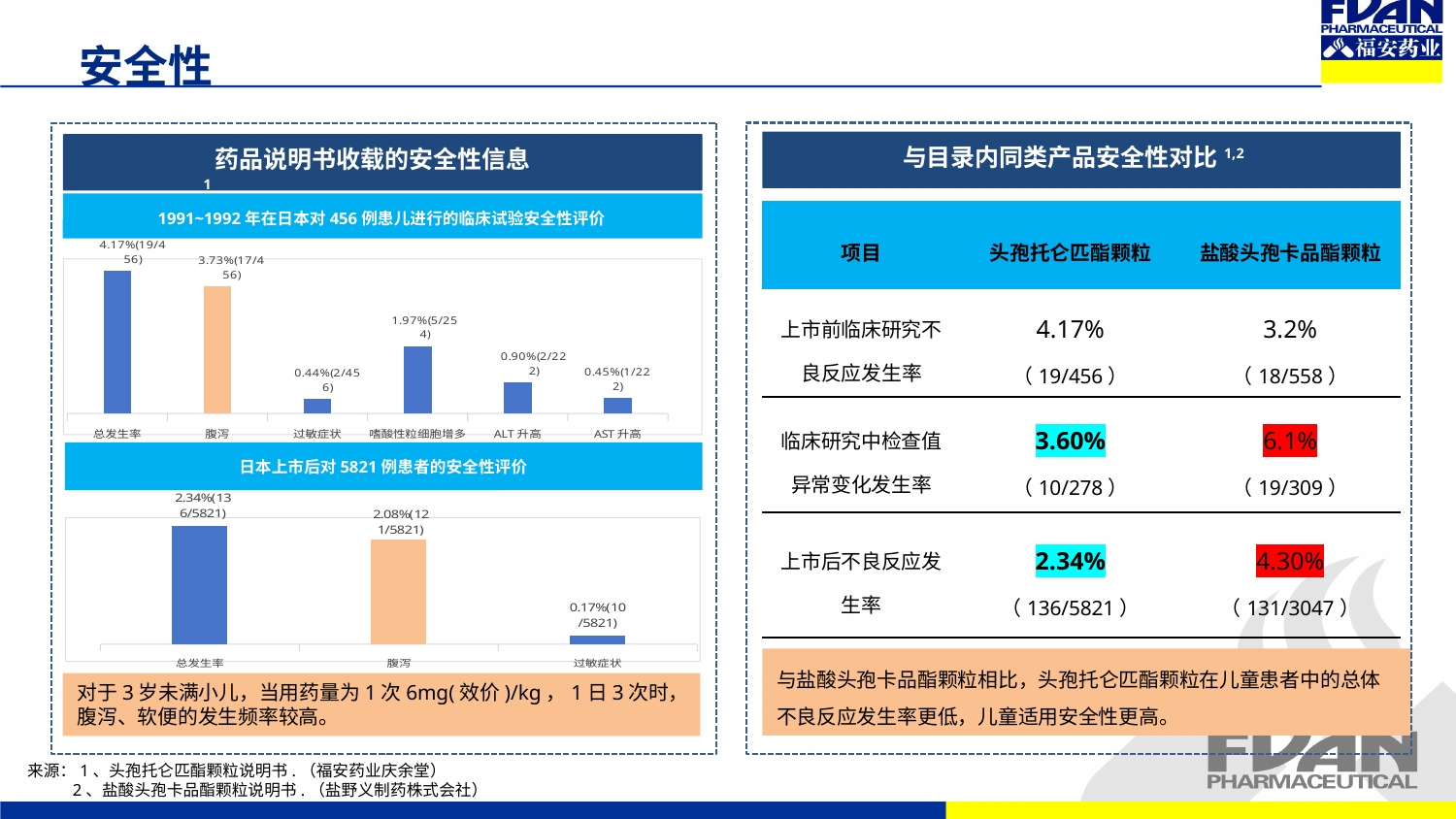
In the bottom chart (post-marketing evaluation of 5821 patients), what is the value for 总发生率? 2.34%(136/5821) In the top chart (1991~1992 clinical trial of 456 patients), which category has the lowest value? 过敏症状 In the top chart (1991~1992 clinical trial of 456 patients), which is larger, ALT 升高 or AST 升高? ALT 升高 In the top chart (1991~1992 clinical trial of 456 patients), how many categories are shown on the x axis? 6 In the top chart (1991~1992 clinical trial of 456 patients), what is the value for 嗜酸性粒细胞增多? 1.97%(5/254) In the bottom chart (post-marketing evaluation of 5821 patients), how many categories are shown? 3 In the top chart (1991~1992 clinical trial of 456 patients), which category has the highest value? 总发生率 In the bottom chart (post-marketing evaluation of 5821 patients), do the values rise or fall from left to right along the x axis? fall In the top chart (1991~1992 clinical trial of 456 patients), what is the value for 腹泻? 3.73%(17/456) In the top chart (1991~1992 clinical trial of 456 patients), what is the value for 总发生率? 4.17%(19/456) What type of chart is the bottom chart (post-marketing evaluation of 5821 patients)? bar chart In the bottom chart (post-marketing evaluation of 5821 patients), what is the value for 过敏症状? 0.17%(10/5821)